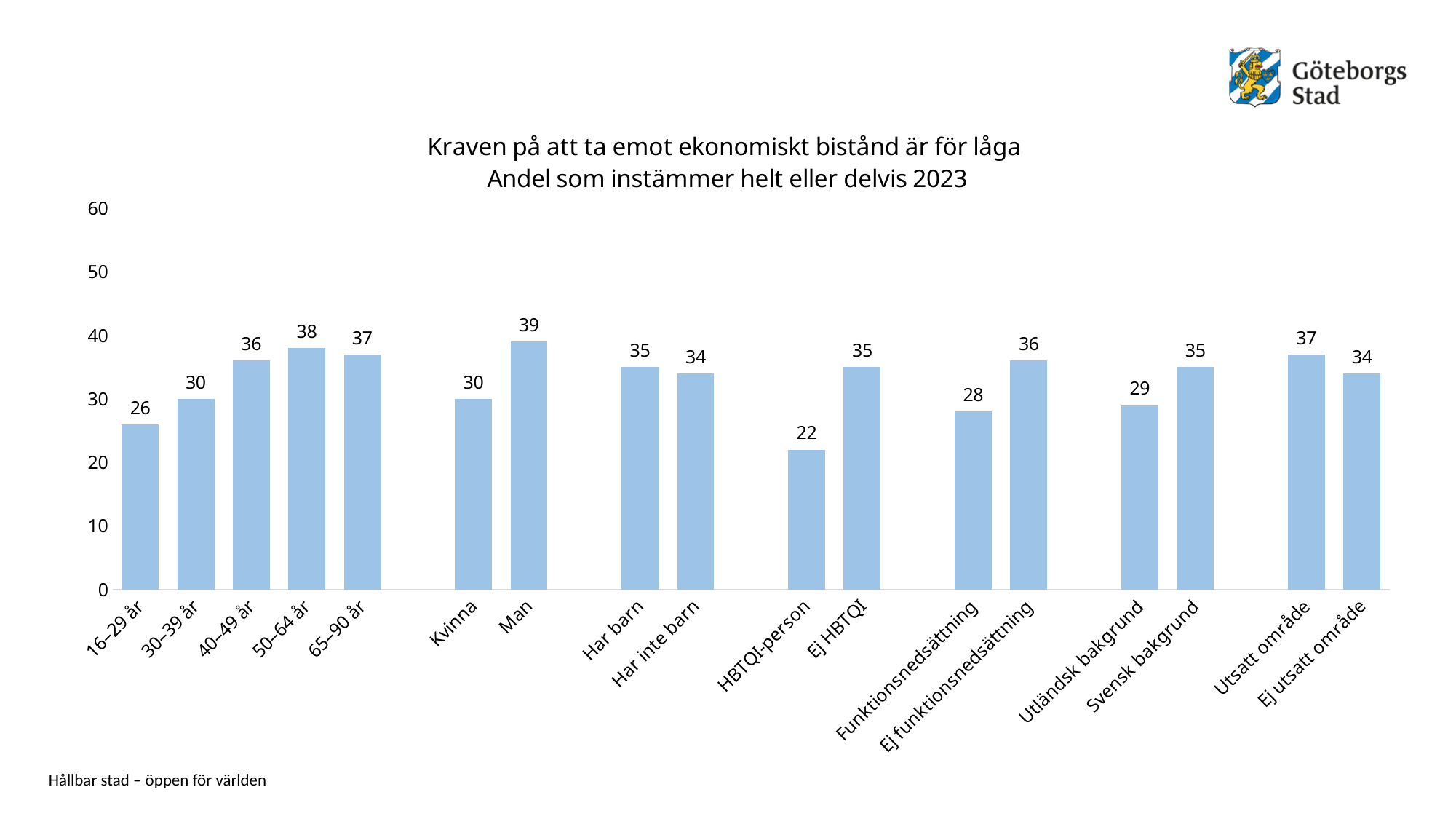
Which category has the highest value? Man What is the difference between the values for Man and Kvinna? 9 What is the value for HBTQI-person? 22 What is the value for Utländsk bakgrund? 29 What is the difference between the values for Ej HBTQI and HBTQI-person? 13 What is the first line of the chart title? Kraven på att ta emot ekonomiskt bistånd är för låga What is the value for Man? 39 How many categories are shown on the x axis? 17 Which category has the lowest value? HBTQI-person Is the value for 16–29 år greater or less than 30? less Which is larger, the value for Funktionsnedsättning or Ej funktionsnedsättning? Ej funktionsnedsättning What kind of chart is shown on the slide? bar chart